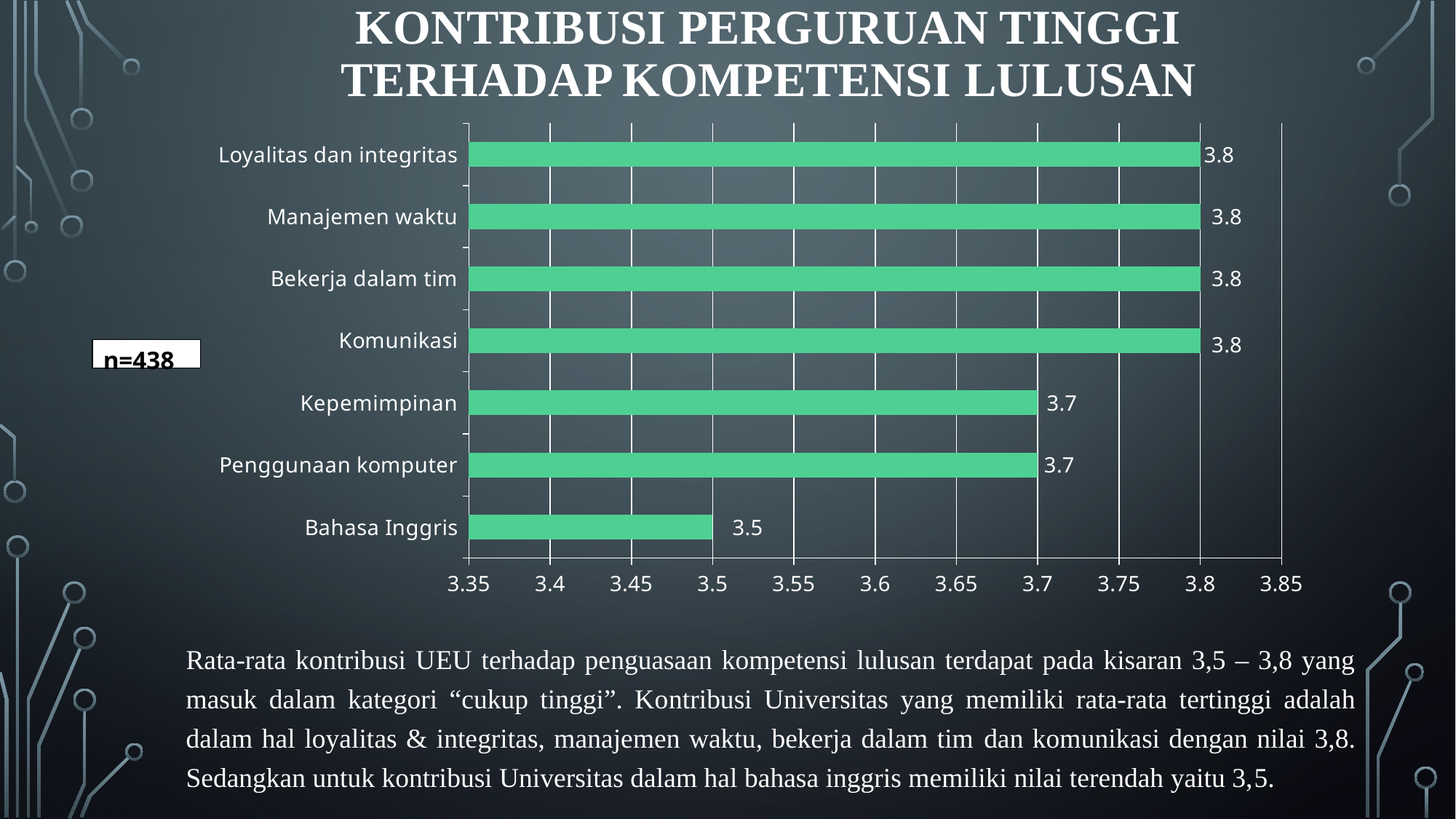
Is the value for Bahasa Inggris greater or less than 3.6? less Which category has the lowest value? Bahasa Inggris What is the value for Komunikasi? 3.8 Which is larger, the value for Manajemen waktu or the value for Penggunaan komputer? Manajemen waktu What is the difference between the values for Kepemimpinan and Bahasa Inggris? 0.2 How many categories are shown in the chart? 7 What is the value for Bahasa Inggris? 3.5 What kind of chart is shown on the slide? bar chart What is the difference between the values for Loyalitas dan integritas and Bahasa Inggris? 0.3 What sample size (n) is shown next to the chart? n=438 What is the value for Kepemimpinan? 3.7 What is the value for Penggunaan komputer? 3.7